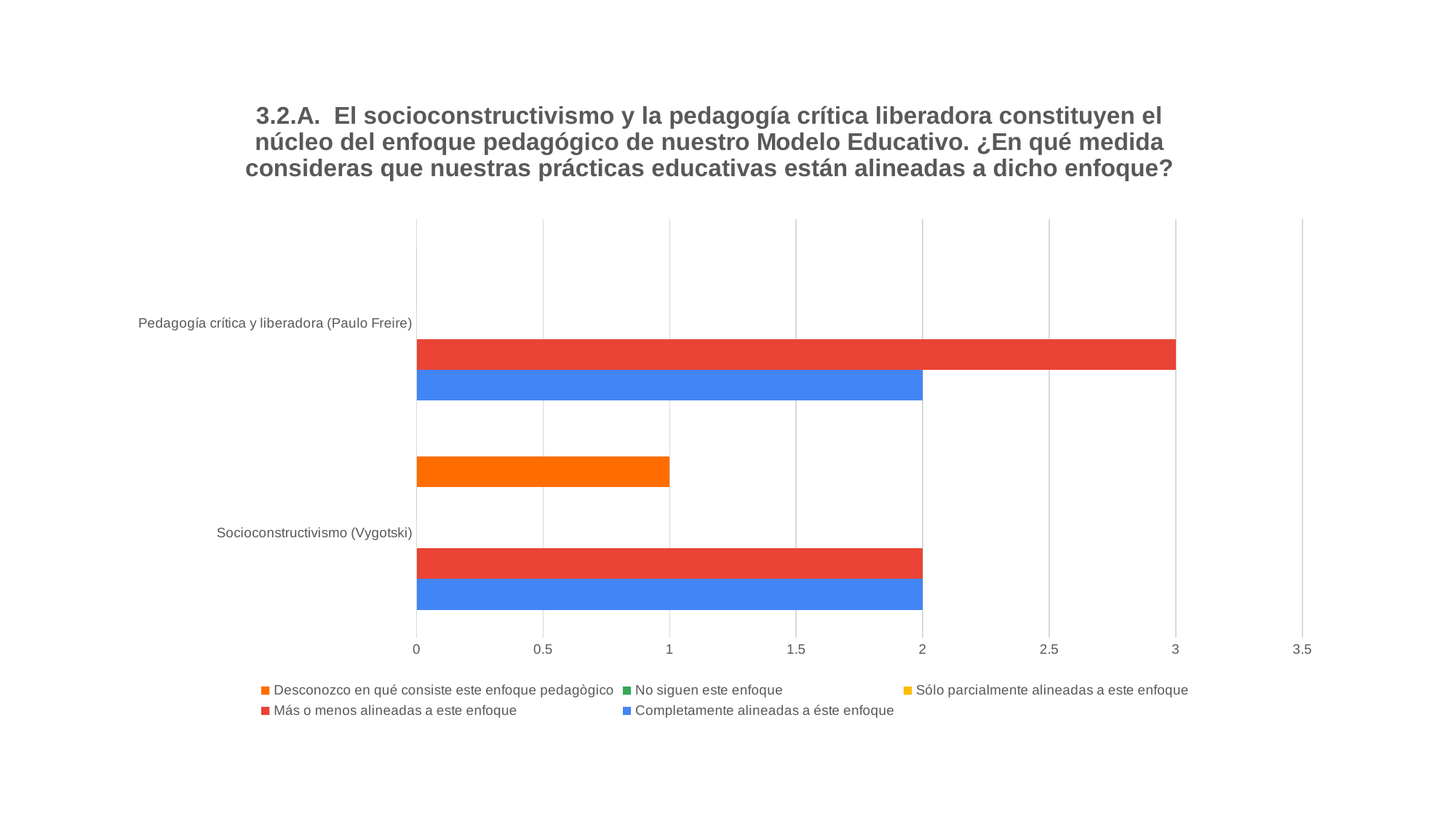
What is the difference between the 'Más o menos alineadas a este enfoque' values for 'Pedagogía crítica y liberadora (Paulo Freire)' and 'Socioconstructivismo (Vygotski)'? 1 What colour represents 'Completamente alineadas a éste enfoque' in the legend? blue What kind of chart is shown on the slide? bar chart How many series does the legend list? 5 For 'Pedagogía crítica y liberadora (Paulo Freire)', which is larger: 'Más o menos alineadas a este enfoque' or 'Completamente alineadas a éste enfoque'? Más o menos alineadas a este enfoque Which category has the higher value for 'Más o menos alineadas a este enfoque'? Pedagogía crítica y liberadora (Paulo Freire) What is the value of 'Desconozco en qué consiste este enfoque pedagògico' for 'Socioconstructivismo (Vygotski)'? 1 What is the value of 'Más o menos alineadas a este enfoque' for 'Pedagogía crítica y liberadora (Paulo Freire)'? 3 What is the value of 'Más o menos alineadas a este enfoque' for 'Socioconstructivismo (Vygotski)'? 2 Is the value of 'Más o menos alineadas a este enfoque' for 'Pedagogía crítica y liberadora (Paulo Freire)' greater or less than 2.5? greater How many categories are shown on the vertical axis? 2 What is the value of 'Completamente alineadas a éste enfoque' for 'Pedagogía crítica y liberadora (Paulo Freire)'? 2